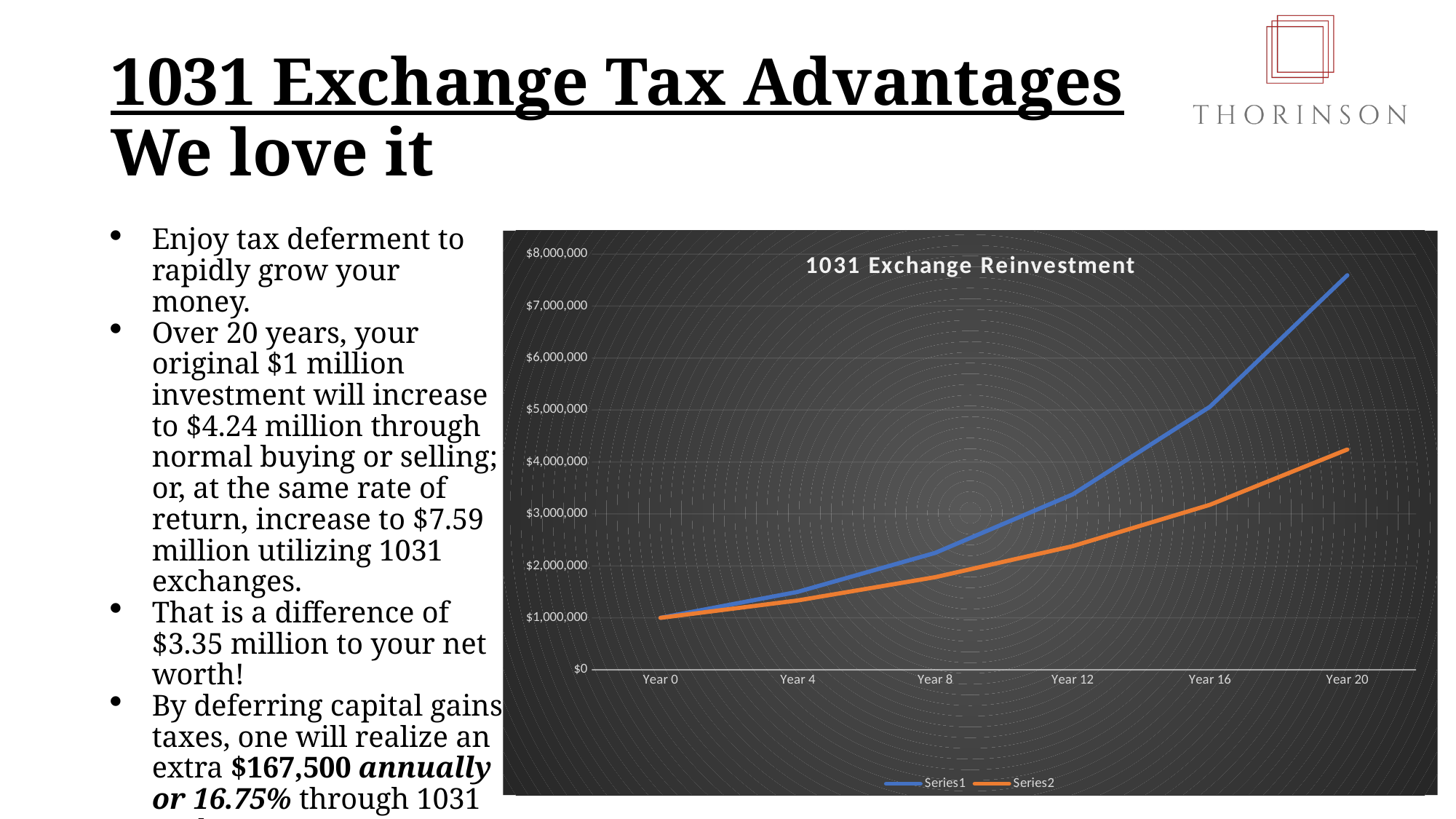
Is the value of Series1 at Year 20 greater or less than $7,000,000? greater What is the value of Series1 at Year 0? $1,000,000 How many year points are labelled on the x axis of the chart? 6 What type of chart is shown on the slide? Line chart What is the value of Series2 at Year 0? $1,000,000 Is the value of Series2 at Year 8 greater or less than $2,000,000? less How many series does the chart legend list? 2 Is the value of Series2 at Year 20 greater or less than $5,000,000? less What is the title of the chart? 1031 Exchange Reinvestment Which colour is used for the Series2 line in the chart? Orange Do the values of Series1 rise or fall from Year 0 to Year 20? Rise Which series has the higher value at Year 20, Series1 or Series2? Series1